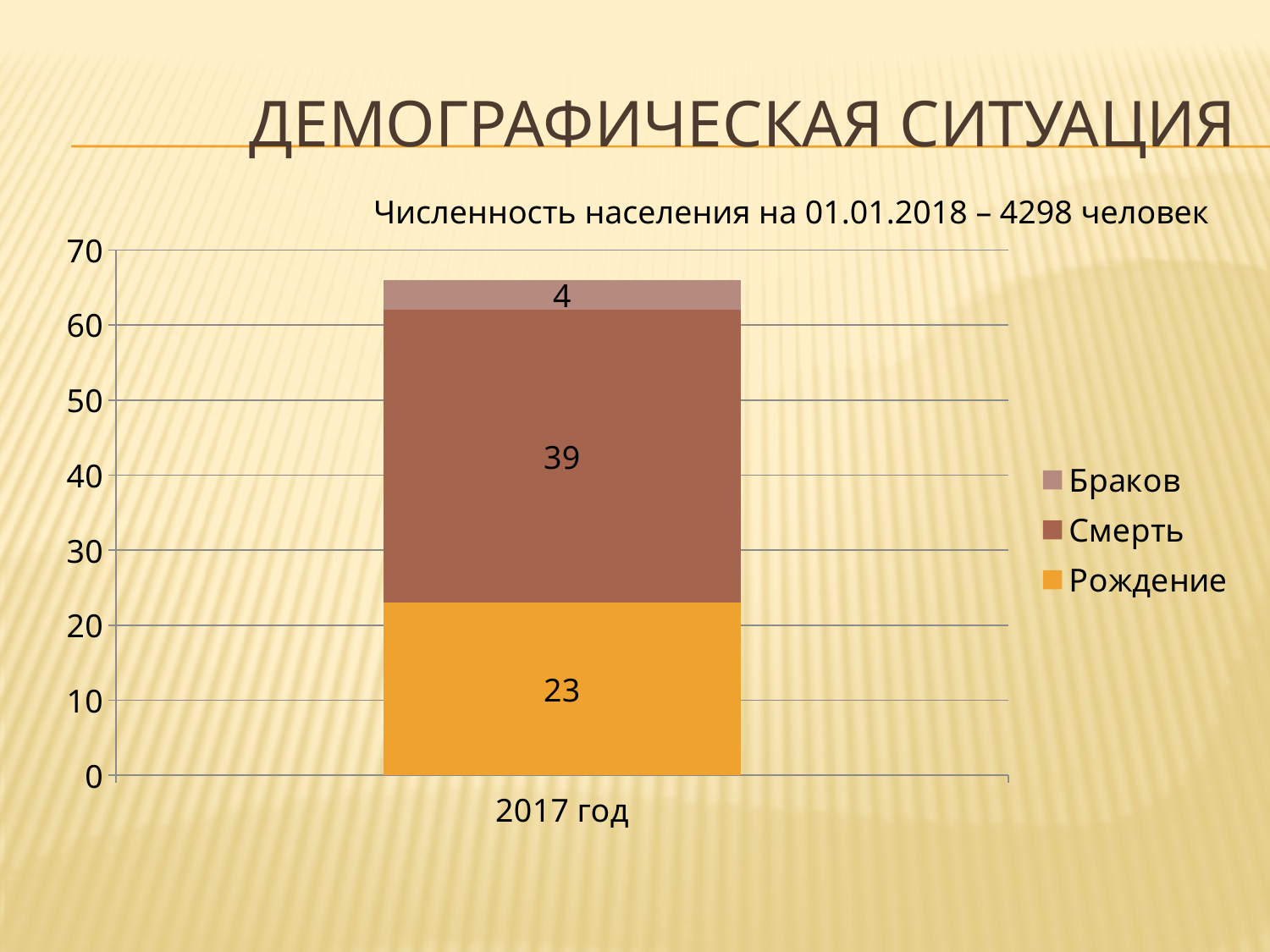
What is the value for Смерть in 2017 год? 39 How many series does the legend list? 3 What kind of chart is shown on the slide? Stacked bar chart What is the difference between Смерть and Рождение in 2017 год? 16 Which series has the lowest value in 2017 год? Браков What is the total of the stacked bar for 2017 год? 66 What is the value for Рождение in 2017 год? 23 Which series has the highest value in 2017 год? Смерть What is the value for Браков in 2017 год? 4 Which is larger in 2017 год, Рождение or Смерть? Смерть What is the title of the chart? Численность населения на 01.01.2018 – 4298 человек How many categories are shown on the x axis? 1